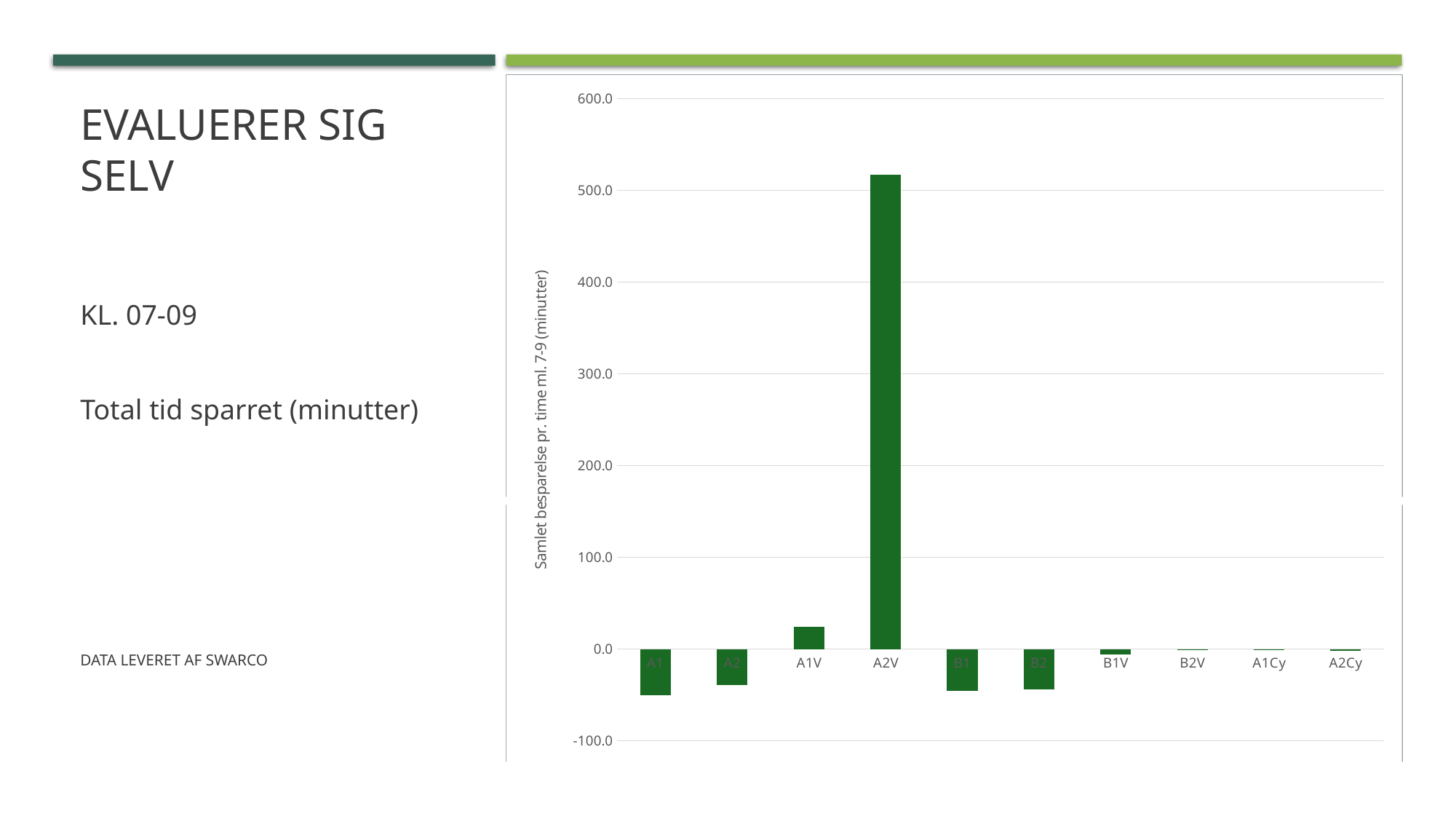
Which category has the highest value in the chart? A2V Which has the larger value, A2V or A1V? A2V What is the label of the vertical axis of the chart? Samlet besparelse pr. time ml. 7-9 (minutter) Is the value for A1V greater or less than 100? less Is the value for A2V greater or less than 500? greater Which has the larger value, A1 or A1V? A1V Is the value for A1 greater or less than 0? less How many categories are shown on the x axis of the chart? 10 What kind of chart is shown on the slide? bar chart What is the lowest value shown on the vertical axis of the chart? -100.0